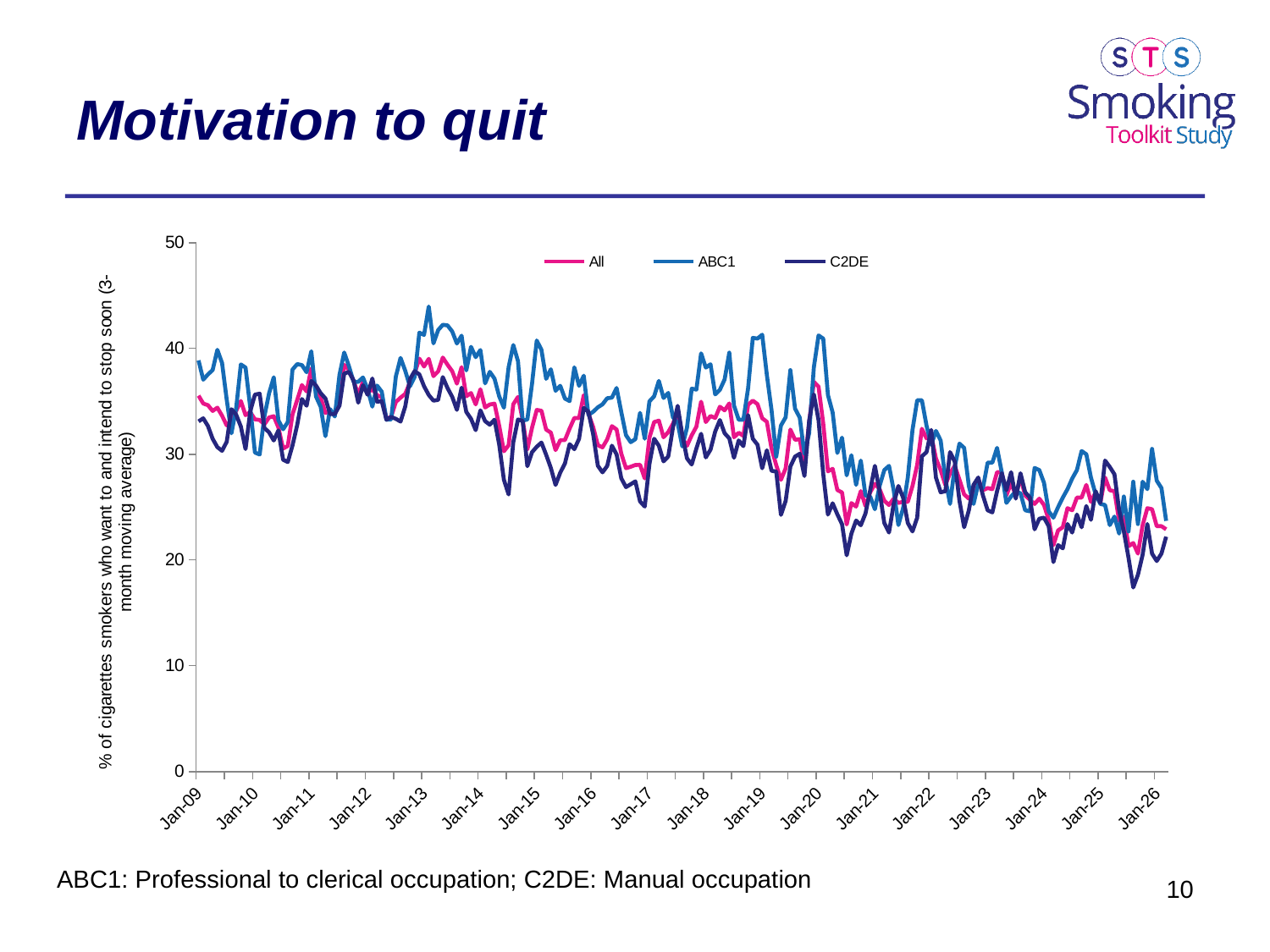
Which series reaches the lowest value anywhere on the chart? C2DE What kind of chart is shown on the slide? line chart Is the peak value for ABC1 around Jan-13 greater or less than 40? greater What is the title of the slide containing the chart? Motivation to quit How many series does the legend list? 3 Overall, do the plotted values rise or fall from Jan-09 to Jan-26? fall Is the value for All at Jan-09 greater or less than 30? greater Which series reaches the highest value anywhere on the chart? ABC1 How many year labels are shown on the x axis? 18 What are the three series named in the legend? All, ABC1, C2DE Is the lowest value for C2DE, shortly before Jan-26, greater or less than 20? less Around Jan-13, which series is higher, ABC1 or C2DE? ABC1